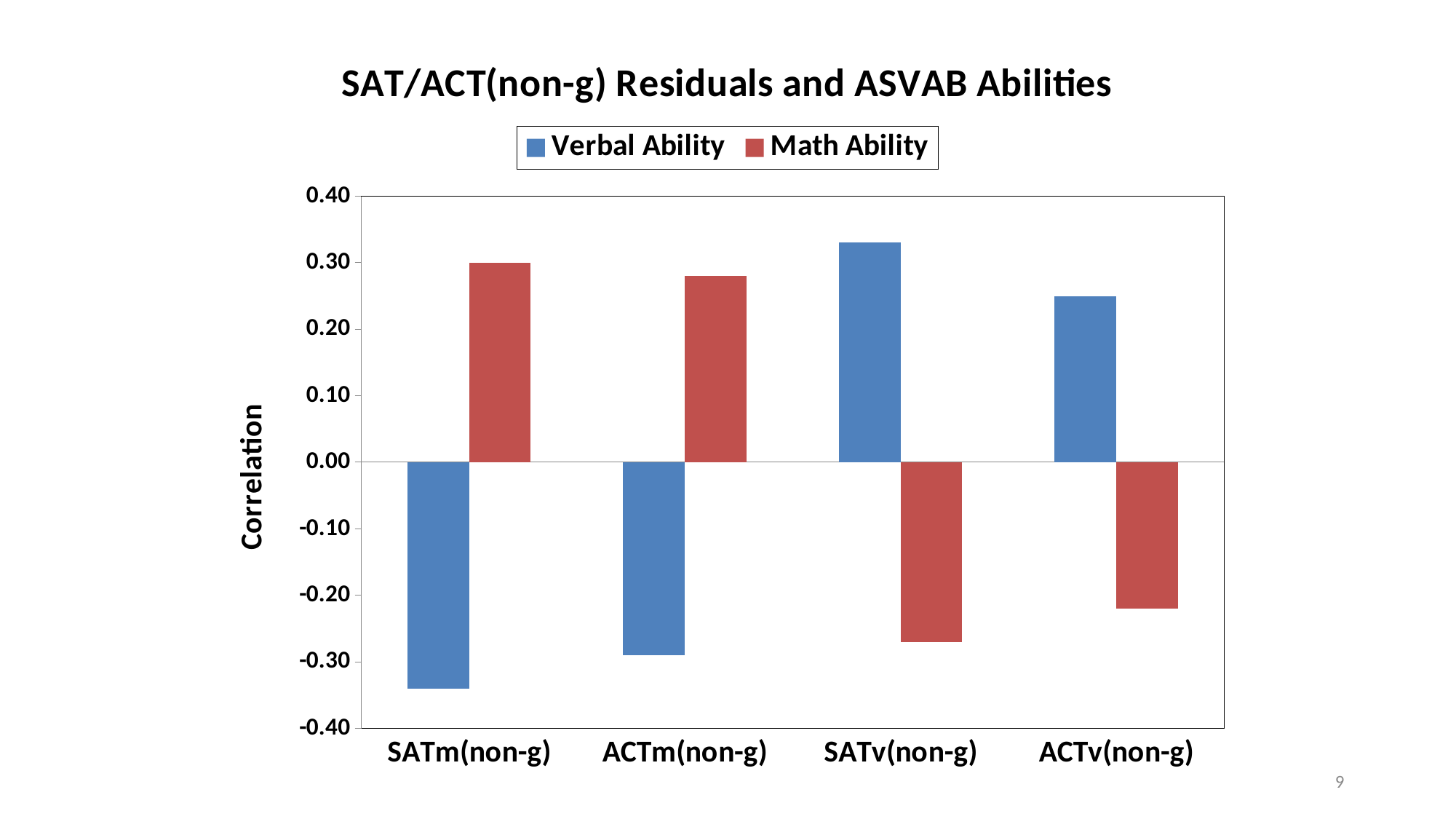
Is the Verbal Ability value for ACTv(non-g) greater or less than 0.20? greater What is the title of the y axis? Correlation Which is larger for SATm(non-g): the Verbal Ability value or the Math Ability value? Math Ability Is the Math Ability value for ACTv(non-g) greater or less than -0.30? greater Is the Math Ability value for SATm(non-g) greater or less than 0.20? greater How many series does the legend list? 2 Which category has the lowest Math Ability correlation? SATv(non-g) What kind of chart is shown on the slide? bar chart How many categories are shown on the x axis? 4 Which category has the highest Verbal Ability correlation? SATv(non-g)